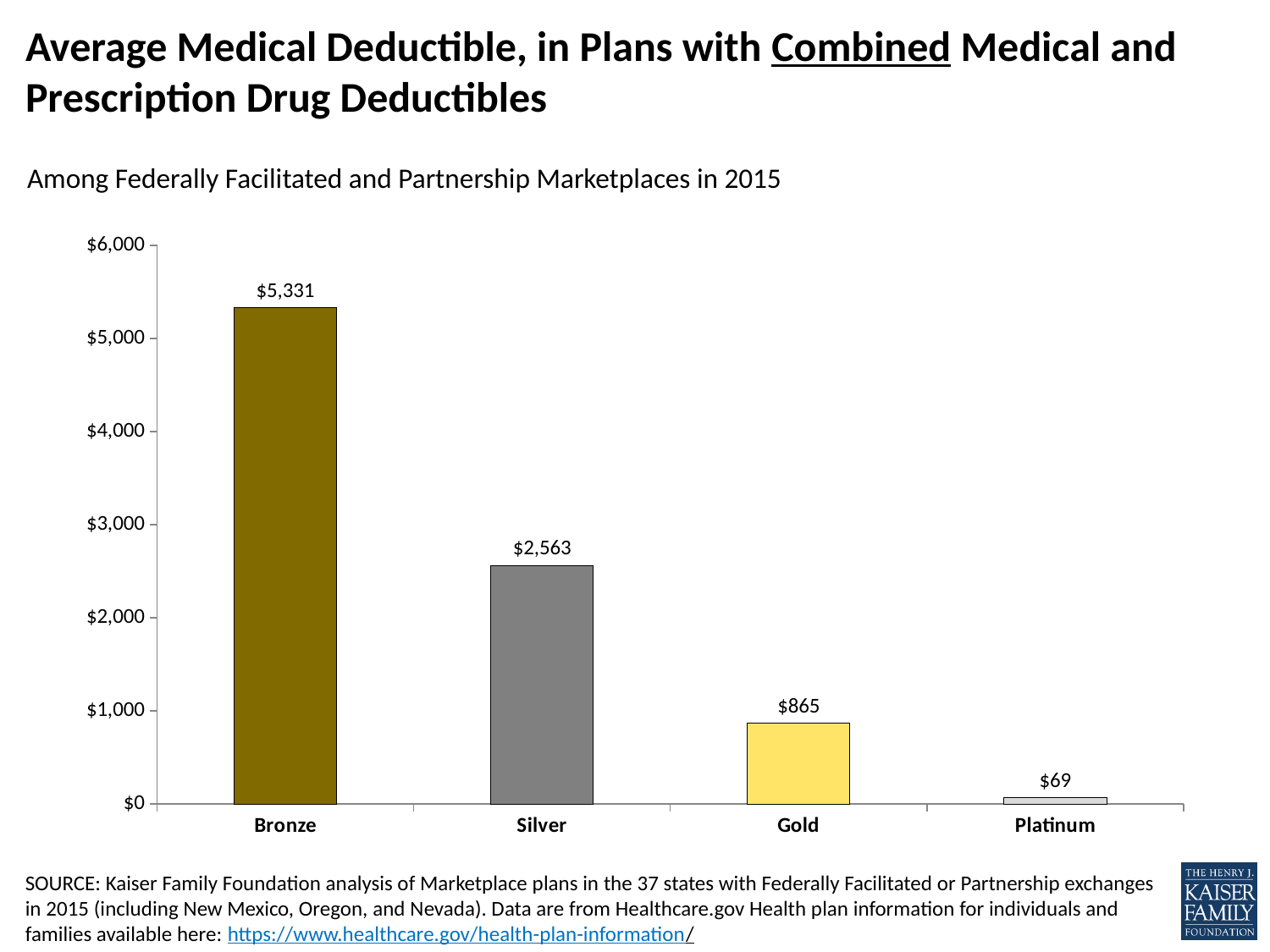
What is the difference between the Gold and Platinum average medical deductibles? $796 What is the average medical deductible for Bronze plans? $5,331 Which plan type has the highest average medical deductible? Bronze What kind of chart is shown on the slide? Bar chart What is the average medical deductible for Gold plans? $865 Do the values rise or fall moving from Bronze to Platinum along the x axis? Fall What is the average medical deductible for Silver plans? $2,563 How many plan types are shown on the chart? 4 What is the difference between the Bronze and Silver average medical deductibles? $2,768 Which has a larger average medical deductible, Silver or Gold? Silver What is the average medical deductible for Platinum plans? $69 Which plan type has the lowest average medical deductible? Platinum